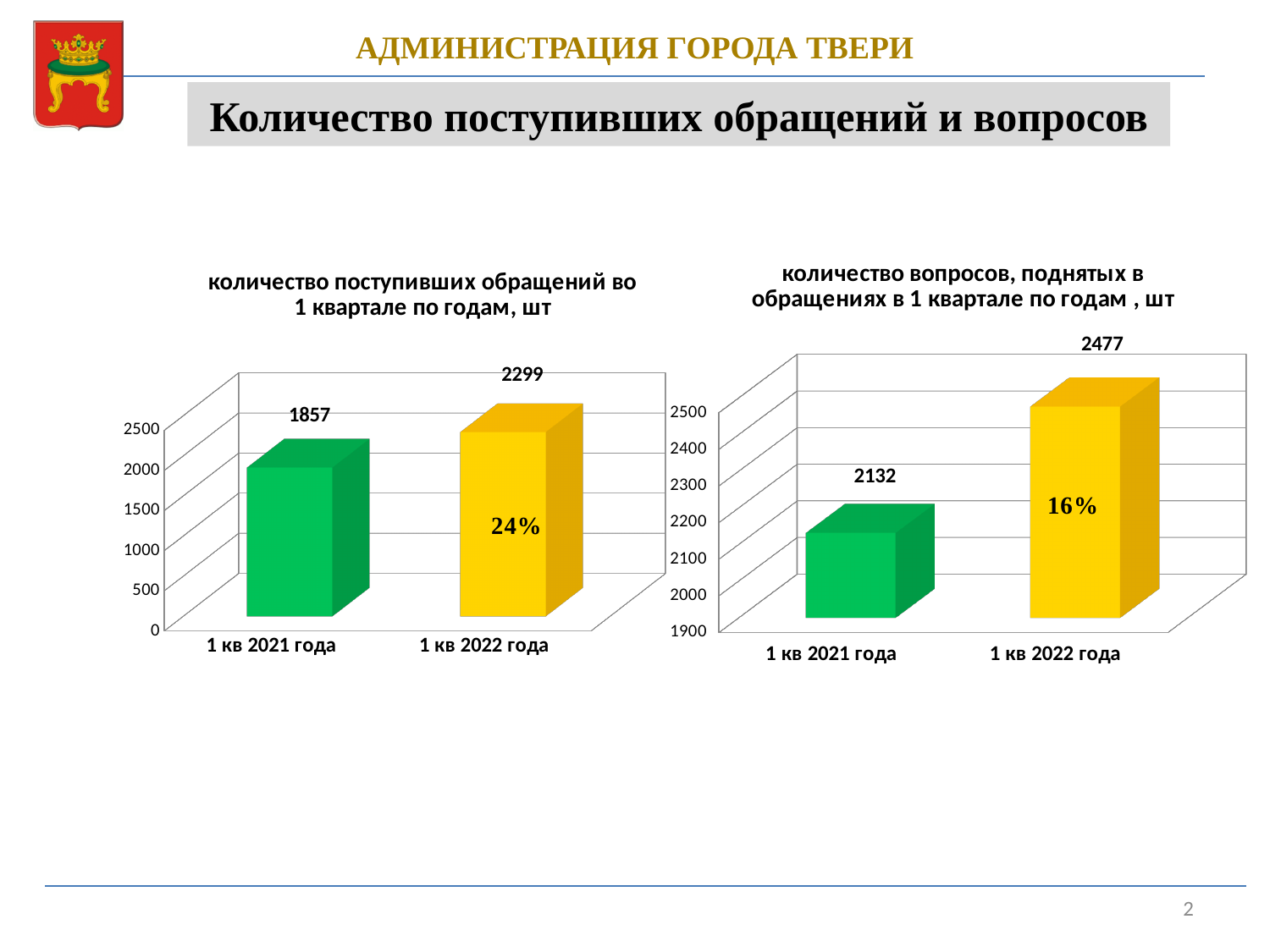
In the right chart, which category has the lowest value? 1 кв 2021 года How many categories are shown in the left chart? 2 In the left chart, what is the difference between the values for 1 кв 2022 года and 1 кв 2021 года? 442 In the right chart (количество вопросов, поднятых в обращениях в 1 квартале по годам, шт), what is the value for 1 кв 2022 года? 2477 In the left chart (количество поступивших обращений во 1 квартале по годам, шт), what is the value for 1 кв 2021 года? 1857 In the left chart, which category has the highest value? 1 кв 2022 года In the right chart, is the value for 1 кв 2021 года greater or less than 2300? less In the right chart, what is the difference between the values for 1 кв 2022 года and 1 кв 2021 года? 345 What percentage label is printed on the 1 кв 2022 года bar in the left chart? 24% What kind of chart is the right chart? bar chart In the left chart (количество поступивших обращений во 1 квартале по годам, шт), what is the value for 1 кв 2022 года? 2299 In the right chart (количество вопросов, поднятых в обращениях в 1 квартале по годам, шт), what is the value for 1 кв 2021 года? 2132